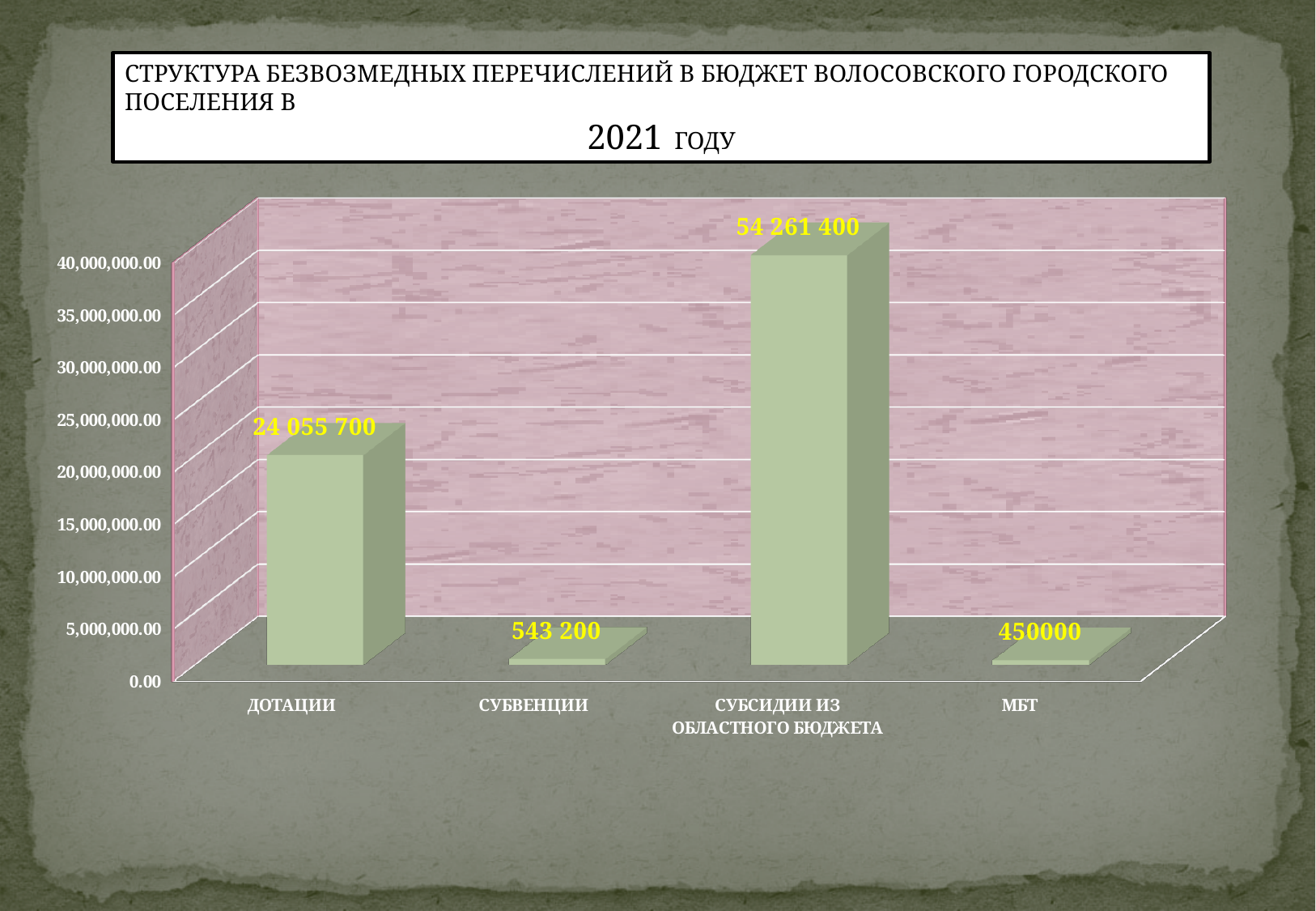
What is the difference between the values for СУБВЕНЦИИ and МБТ? 93 200 What is the value for СУБСИДИИ ИЗ ОБЛАСТНОГО БЮДЖЕТА? 54 261 400 What is the value for СУБВЕНЦИИ? 543 200 Is the value for ДОТАЦИИ greater or less than 20,000,000.00? greater Which category has the highest value? СУБСИДИИ ИЗ ОБЛАСТНОГО БЮДЖЕТА What is the value for ДОТАЦИИ? 24 055 700 Which is larger, the value for ДОТАЦИИ or the value for СУБВЕНЦИИ? ДОТАЦИИ What kind of chart is shown on the slide? bar chart How many categories are shown on the chart? 4 What is the value for МБТ? 450000 Which category has the lowest value? МБТ What is the difference between the values for СУБСИДИИ ИЗ ОБЛАСТНОГО БЮДЖЕТА and ДОТАЦИИ? 30 205 700